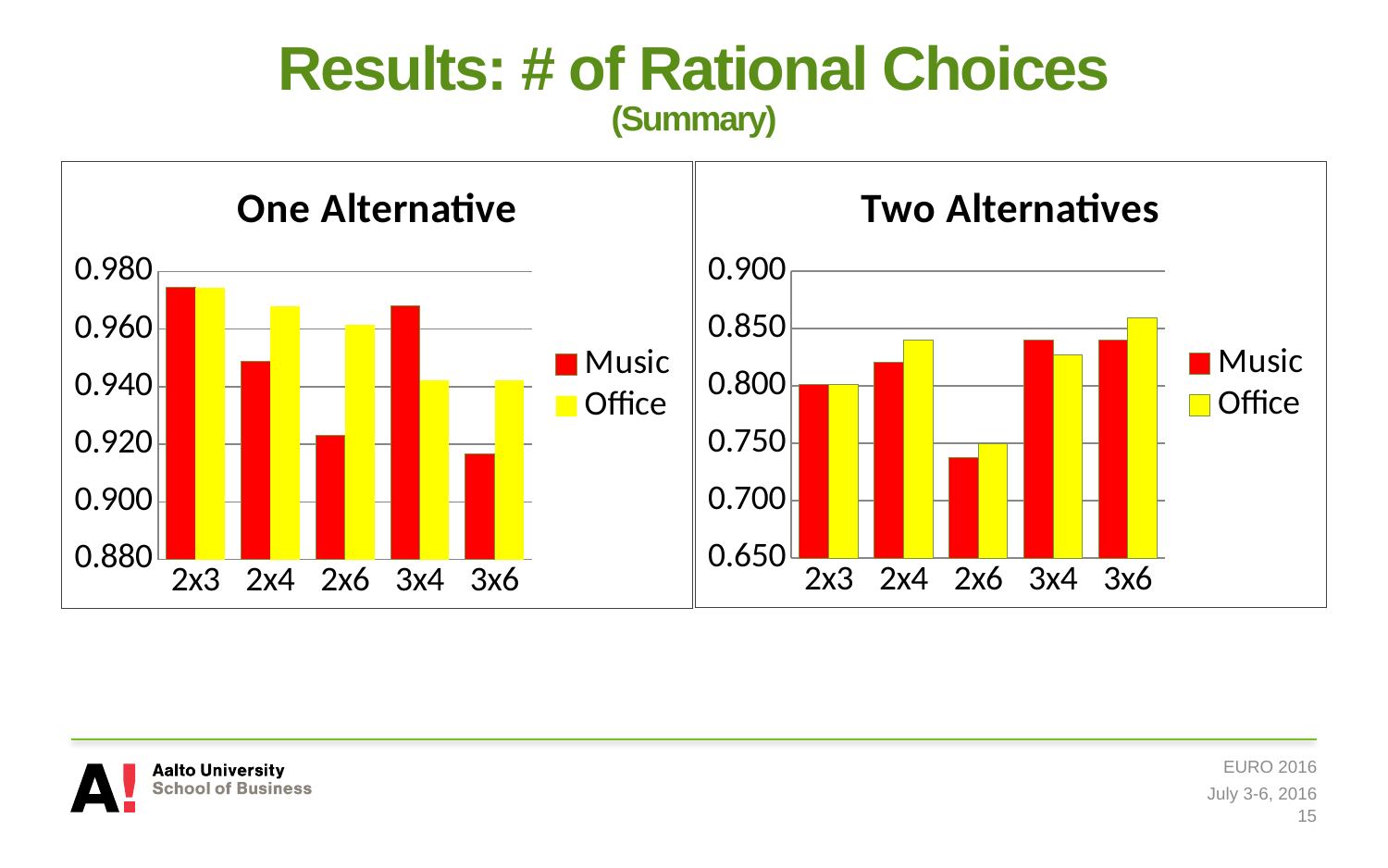
In the Two Alternatives chart, which category has the lowest Music value? 2x6 In the One Alternative chart, what kind of chart is shown? bar chart In the Two Alternatives chart, how many series does the legend list? 2 In the One Alternative chart, is the Music value for 2x6 greater or less than 0.940? less In the Two Alternatives chart, is the Music value for 2x6 greater or less than 0.750? less In the One Alternative chart, which is larger for 2x4: Music or Office? Office In the Two Alternatives chart, what colour represents the Office series? yellow In the One Alternative chart, is the Office value for 2x6 greater or less than 0.940? greater In the One Alternative chart, how many categories are shown on the x axis? 5 In the One Alternative chart, which is larger for 3x4: Music or Office? Music In the Two Alternatives chart, which category has the highest Office value? 3x6